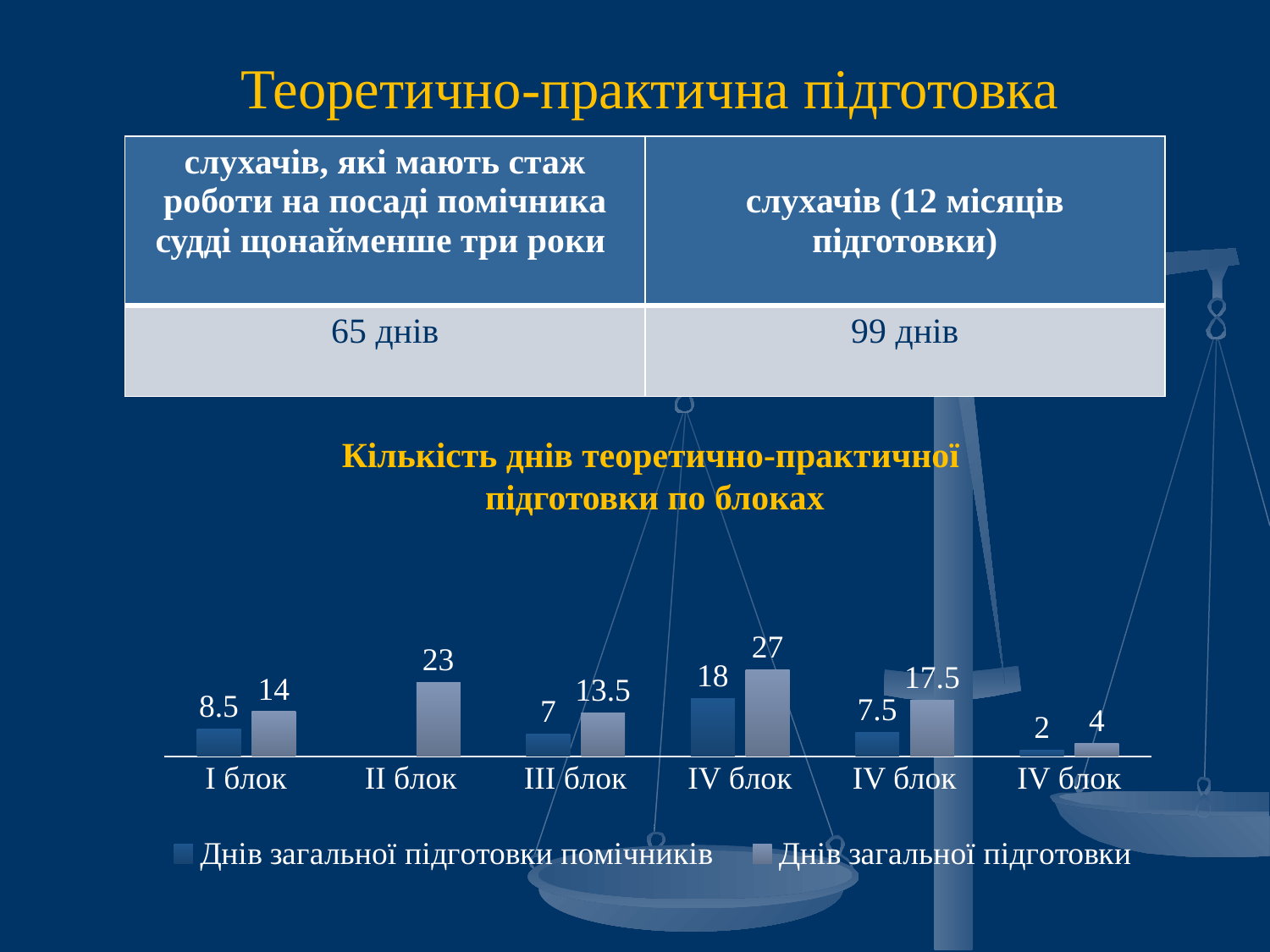
What is the value of 'Днів загальної підготовки помічників' for І блок? 8.5 What is the value of 'Днів загальної підготовки' for ІІ блок? 23 What is the highest value shown for the 'Днів загальної підготовки' series? 27 What is the difference between the two series' values for І блок? 5.5 What is the value of 'Днів загальної підготовки' for ІІІ блок? 13.5 What is the value of 'Днів загальної підготовки' for І блок? 14 How many series does the chart legend list? 2 Which is larger for ІІІ блок: 'Днів загальної підготовки помічників' or 'Днів загальної підготовки'? Днів загальної підготовки What is the chart's title? Кількість днів теоретично-практичної підготовки по блоках How many categories are shown along the x axis of the chart? 6 What is the value of 'Днів загальної підготовки помічників' for ІІІ блок? 7 What type of chart is shown on the slide? bar chart